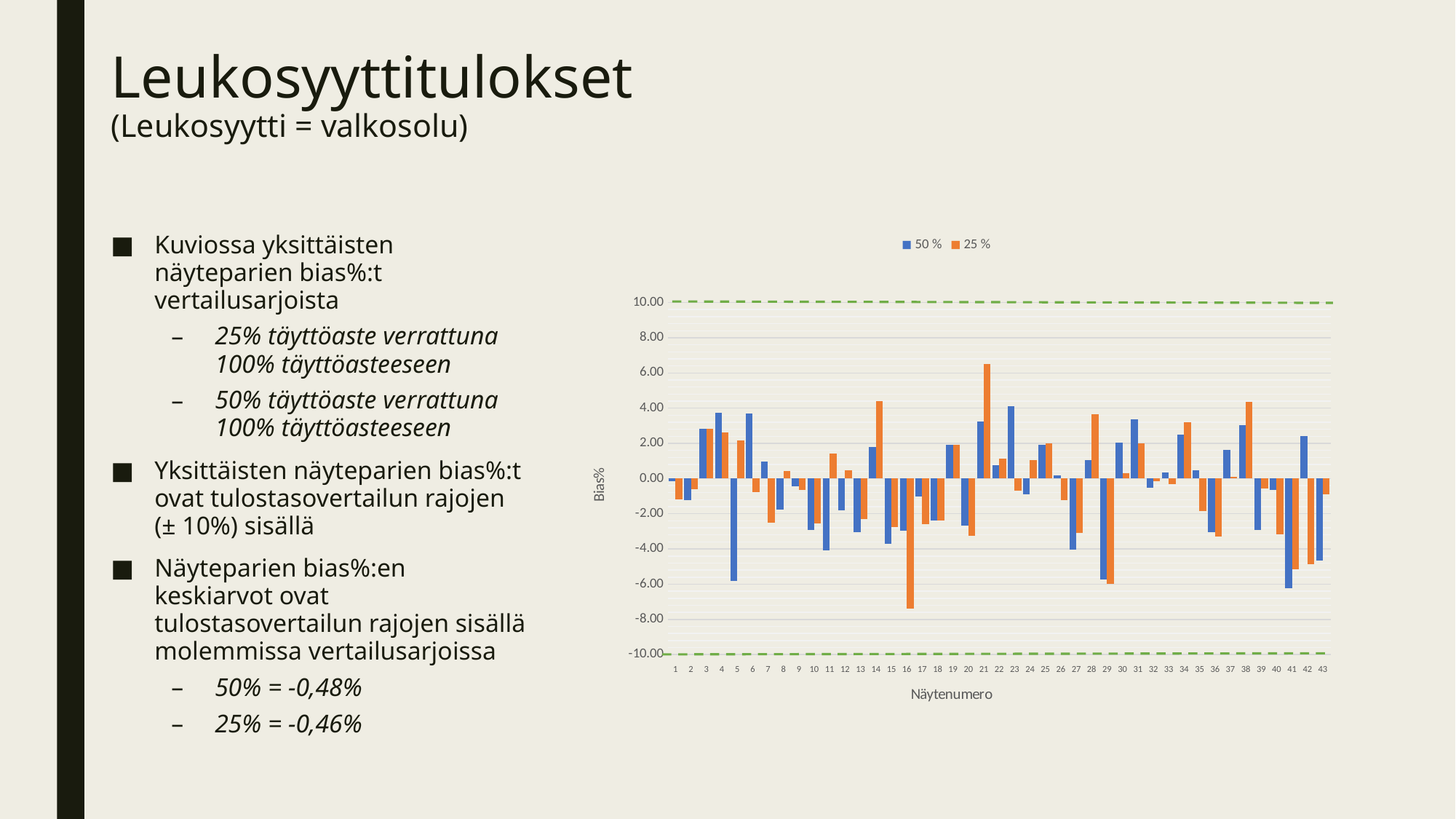
Which sample number has the lowest value in the 25 % series? 16 What are the two series named in the chart legend? 50 % and 25 % What kind of chart is shown on the slide? Bar chart What is the title of the vertical axis of the chart? Bias% Which sample number has the highest value in the 25 % series? 21 Is the 25 % value for sample 21 greater or less than 4.00? greater For sample 21, which series has the larger value, 50 % or 25 %? 25 % How many series does the chart legend list? 2 How many sample numbers (Näytenumero) are shown on the x axis of the chart? 43 Is the 50 % value for sample 5 greater or less than -4.00? less Is the 25 % value for sample 16 greater or less than -6.00? less For sample 5, which series has the larger value, 50 % or 25 %? 25 %